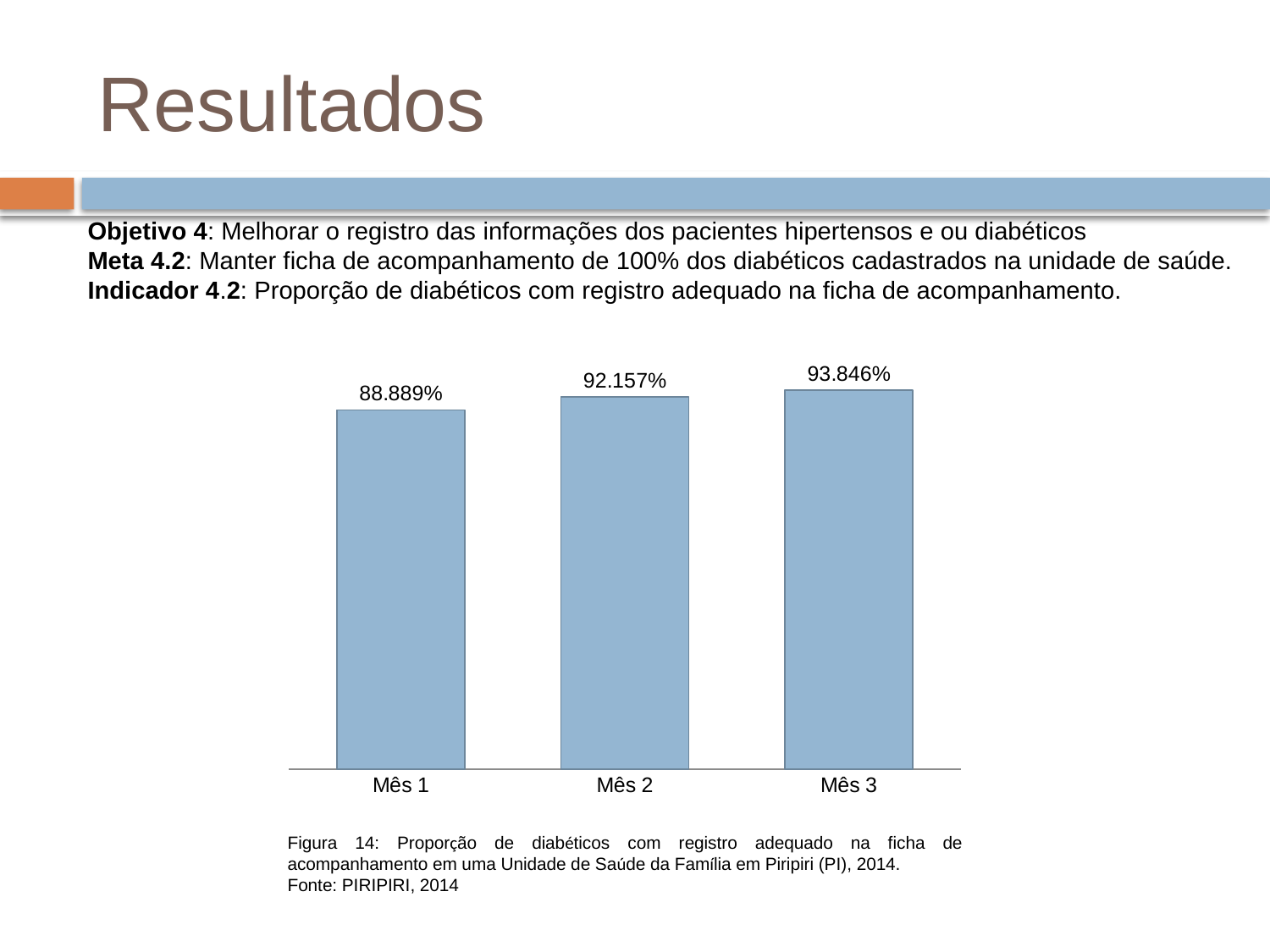
What is the difference between the values for Mês 3 and Mês 1? 4.957% How many bars are shown in the chart? 3 What is the difference between the values for Mês 2 and Mês 1? 3.268% Which month has the highest value? Mês 3 Which month has the lowest value? Mês 1 What is the value for Mês 2? 92.157% What kind of chart is shown on the slide? Bar chart Do the values rise or fall from Mês 1 to Mês 3? Rise What is the figure number given in the caption below the chart? Figura 14 What is the value for Mês 1? 88.889% What is the value for Mês 3? 93.846% Which is larger, the value for Mês 2 or the value for Mês 3? Mês 3